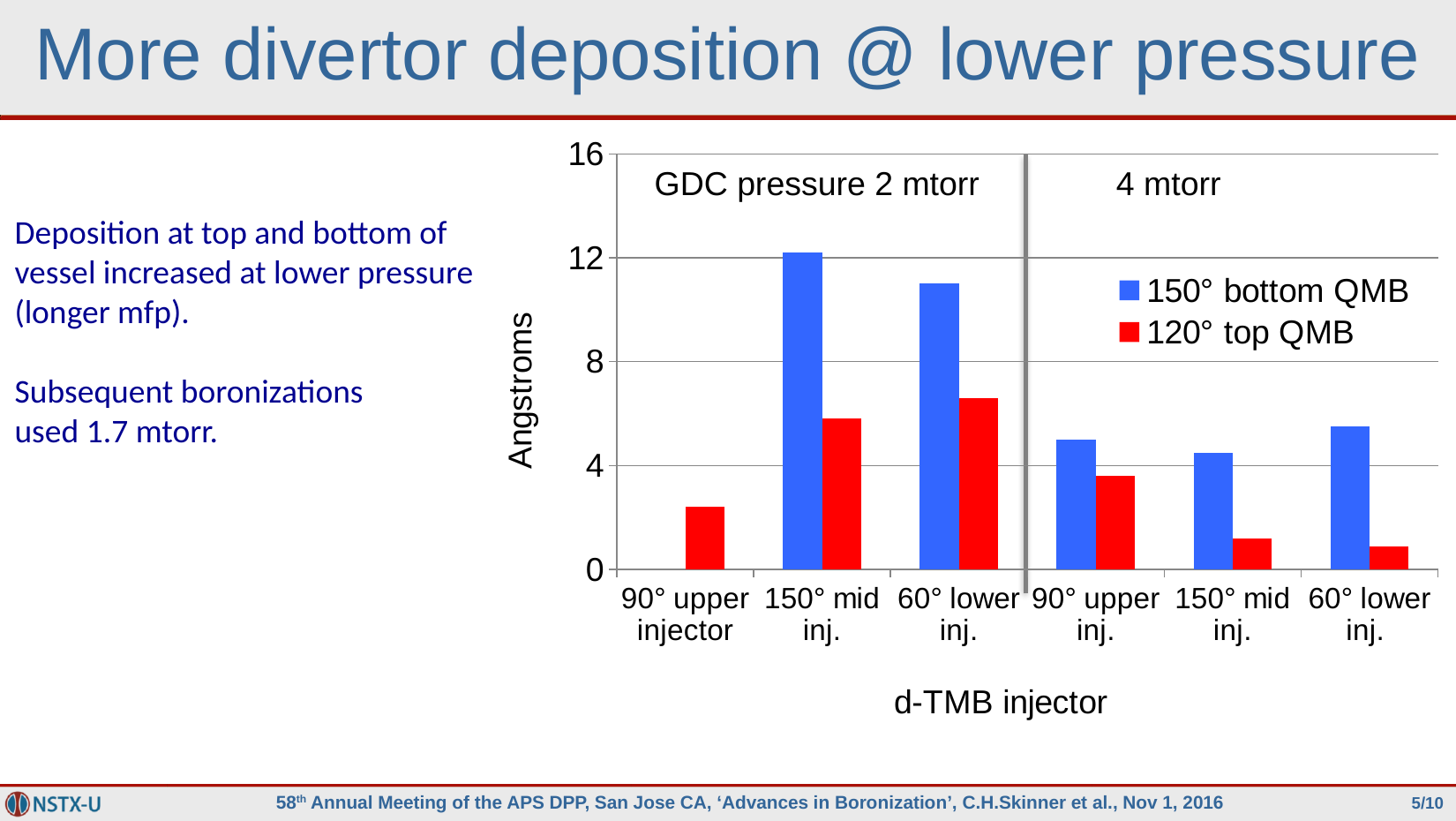
What is the label of the y axis of the chart? Angstroms What kind of chart is shown on the slide? bar chart Is the 150° bottom QMB value for the 60° lower inj. at 4 mtorr greater or less than 4? greater Is the 150° bottom QMB value for the 150° mid inj. at 2 mtorr greater or less than 8? greater For the 150° bottom QMB series, which injector category has the highest value? 150° mid inj. (GDC pressure 2 mtorr) How many series does the chart legend list? 2 How many injector categories are shown along the x axis of the chart? 6 Is the 120° top QMB value for the 90° upper injector at 2 mtorr greater or less than 4? less Which series is drawn in red in the chart? 120° top QMB At the 90° upper inj. at 4 mtorr, which series has the larger value, 150° bottom QMB or 120° top QMB? 150° bottom QMB For the 120° top QMB series, which injector category has the highest value? 60° lower inj. (GDC pressure 2 mtorr) At the 60° lower inj. at 2 mtorr, which series has the larger value, 150° bottom QMB or 120° top QMB? 150° bottom QMB